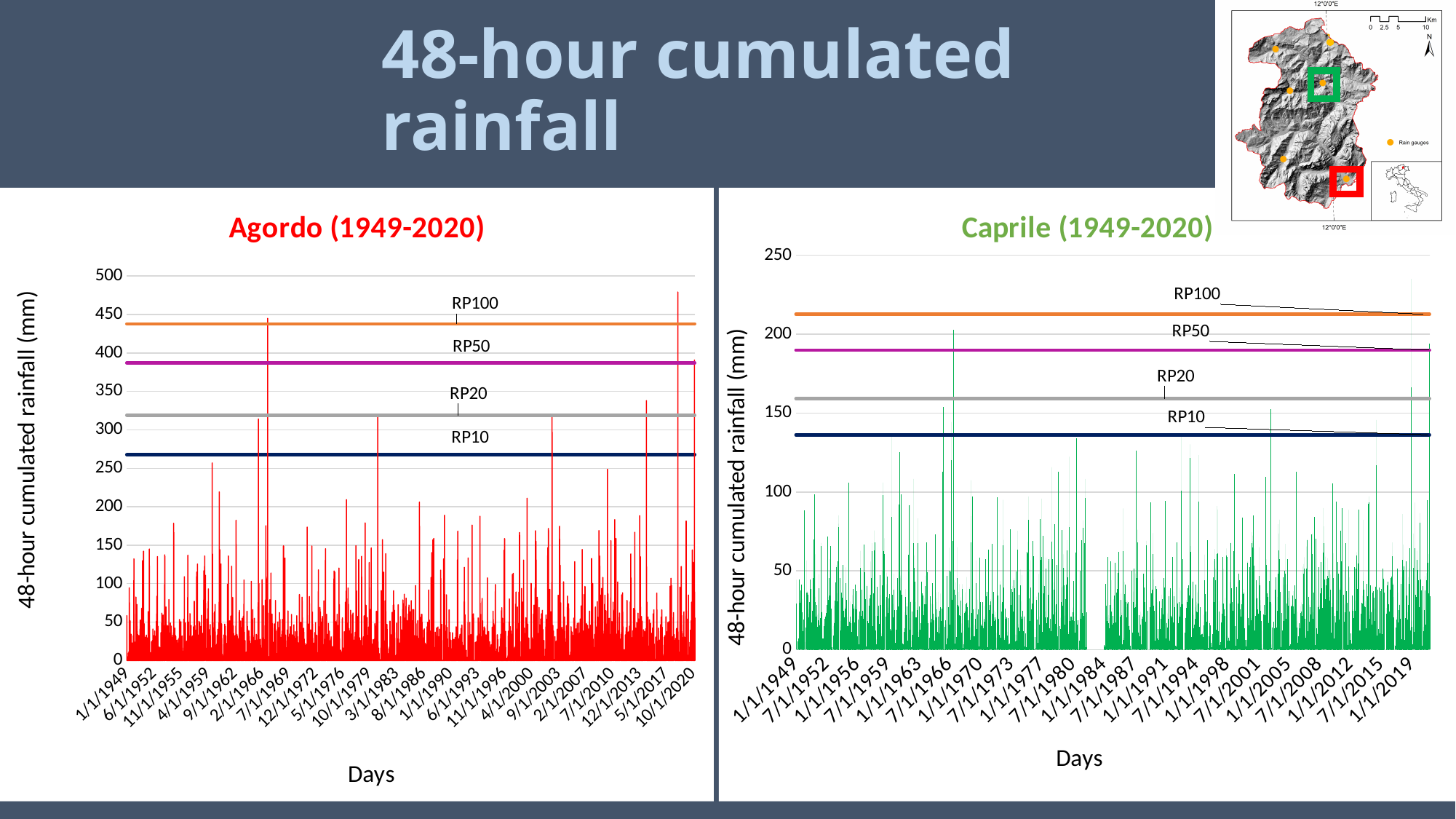
On the Caprile (1949-2020) chart, is the RP10 line greater or less than 150? less What colour are the rainfall data plotted in on the Caprile (1949-2020) chart? Green What is the highest value shown on the y-axis of the Agordo (1949-2020) chart? 500 On the Agordo (1949-2020) chart, which return-period line is the highest? RP100 On the Agordo (1949-2020) chart, is the highest rainfall spike greater or less than 450? greater On the Caprile (1949-2020) chart, which return-period line is the lowest? RP10 On the Caprile (1949-2020) chart, is the RP50 line greater or less than 200? less How many return-period (RP) lines are drawn on the Caprile (1949-2020) chart? 4 Which chart has the higher RP100 line, Agordo (1949-2020) or Caprile (1949-2020)? Agordo (1949-2020)